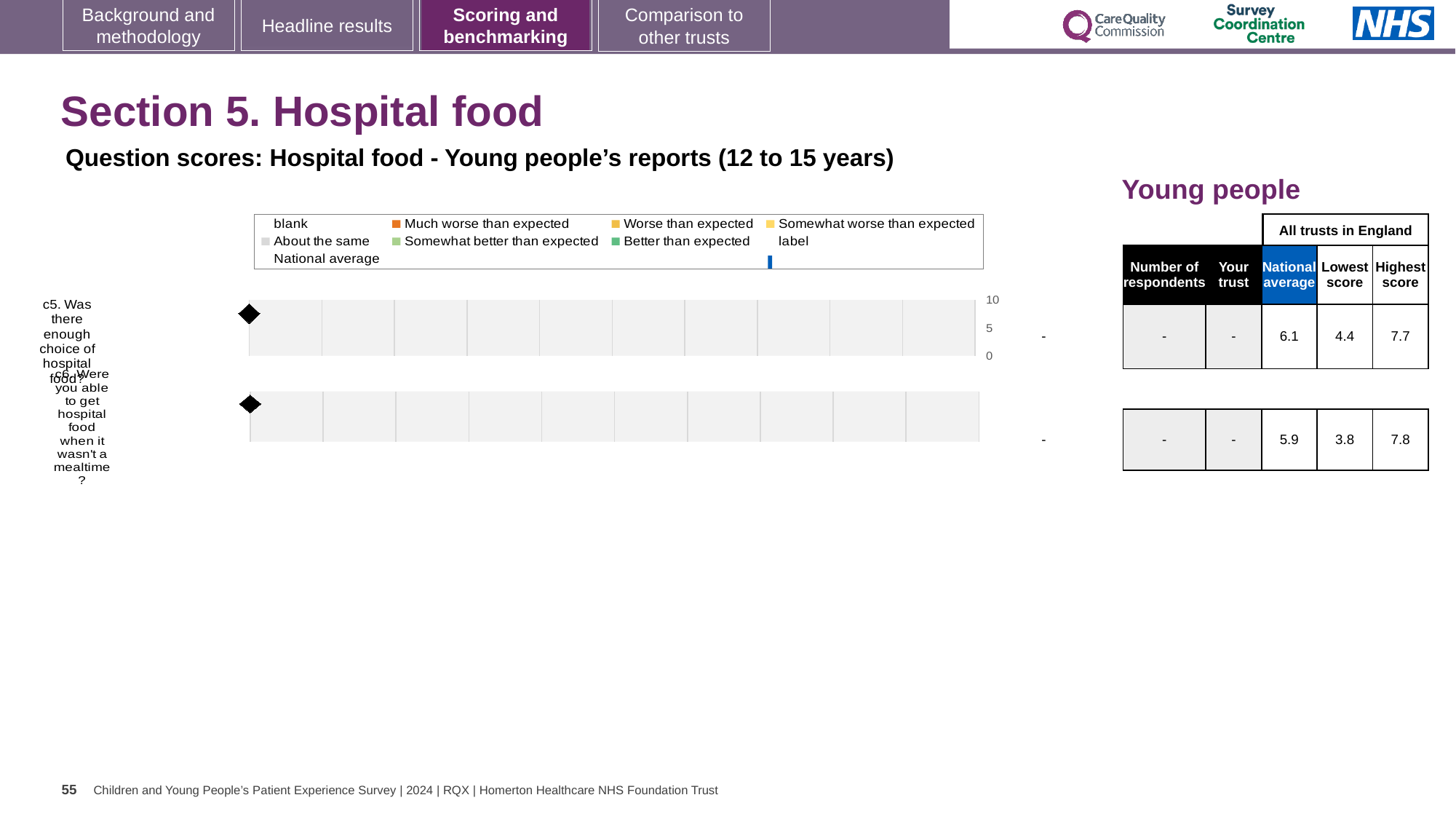
In the table, what is the difference between the highest and lowest scores for c5? 3.3 In the table, what is the highest score for c6 (Were you able to get hospital food when it wasn't a mealtime?)? 7.8 In the table, what is the national average score for c5 (Was there enough choice of hospital food?)? 6.1 What kind of chart is shown on the slide? bar chart In the table, what is the lowest score for c6? 3.8 What is the highest value shown on the chart's score axis? 10 In the table, what is the lowest score for c5? 4.4 In the table, what is the difference between the highest and lowest scores for c6? 4.0 Which question has the higher national average in the table, c5 or c6? c5 How many survey questions (categories) are listed on the chart? 2 Which legend entry is shown with an orange marker? Much worse than expected What value is shown in the 'Your trust' column for c5? -